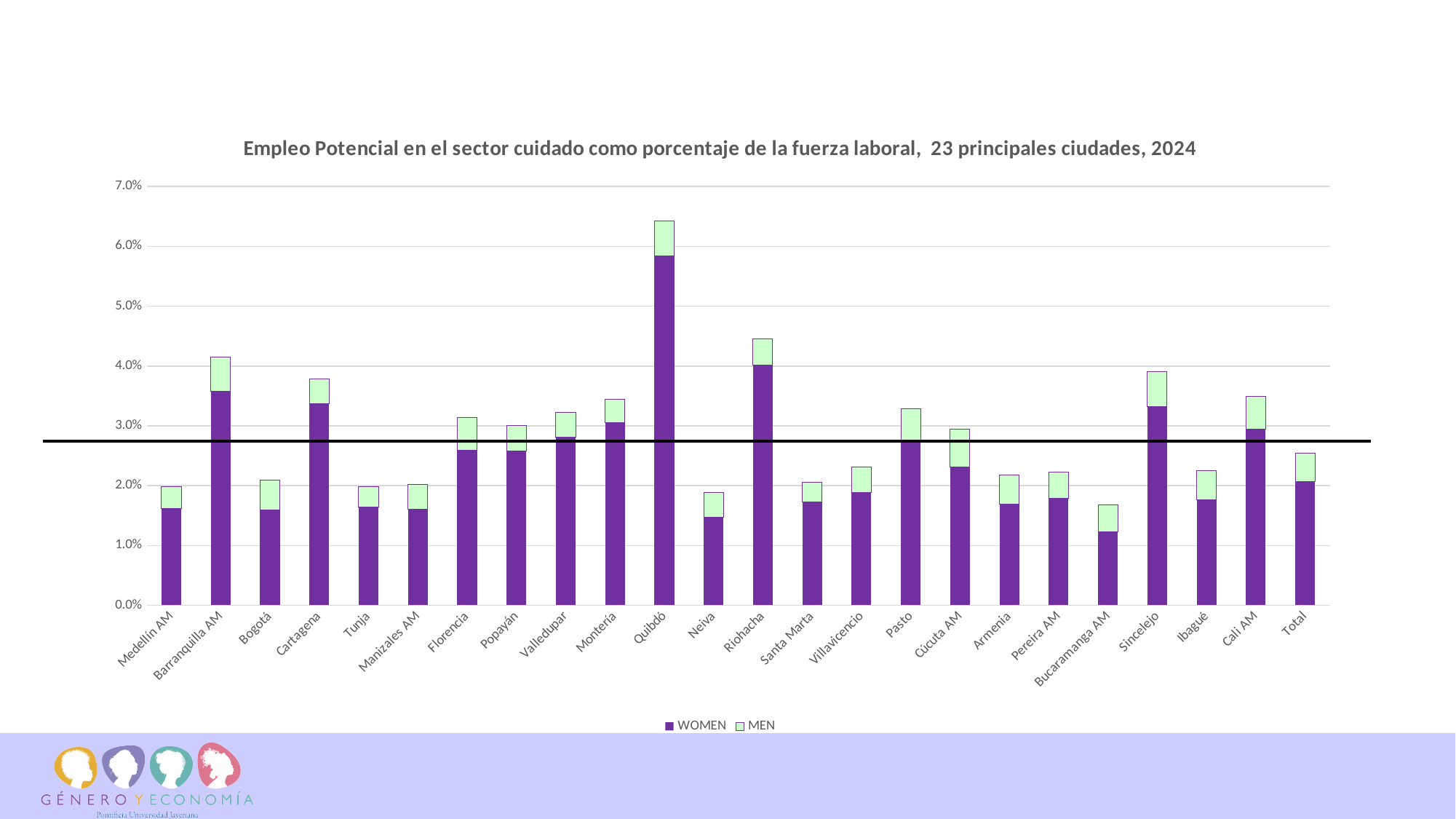
What is the title of the chart? Empleo Potencial en el sector cuidado como porcentaje de la fuerza laboral, 23 principales ciudades, 2024 Is the total value for Quibdó greater or less than 6.0%? greater Is the total value for Bogotá greater or less than 3.0%? less Which category has the lowest total bar? Bucaramanga AM Which category has the largest WOMEN segment? Quibdó How many bars (categories) are plotted on the x axis? 24 Which has a larger total bar, Sincelejo or Cali AM? Sincelejo What kind of chart is shown on the slide? Stacked bar chart Is the total value for Riohacha greater or less than 4.0%? greater Which category has the highest total bar? Quibdó What are the two series named in the legend? WOMEN and MEN How many series does the legend list? 2